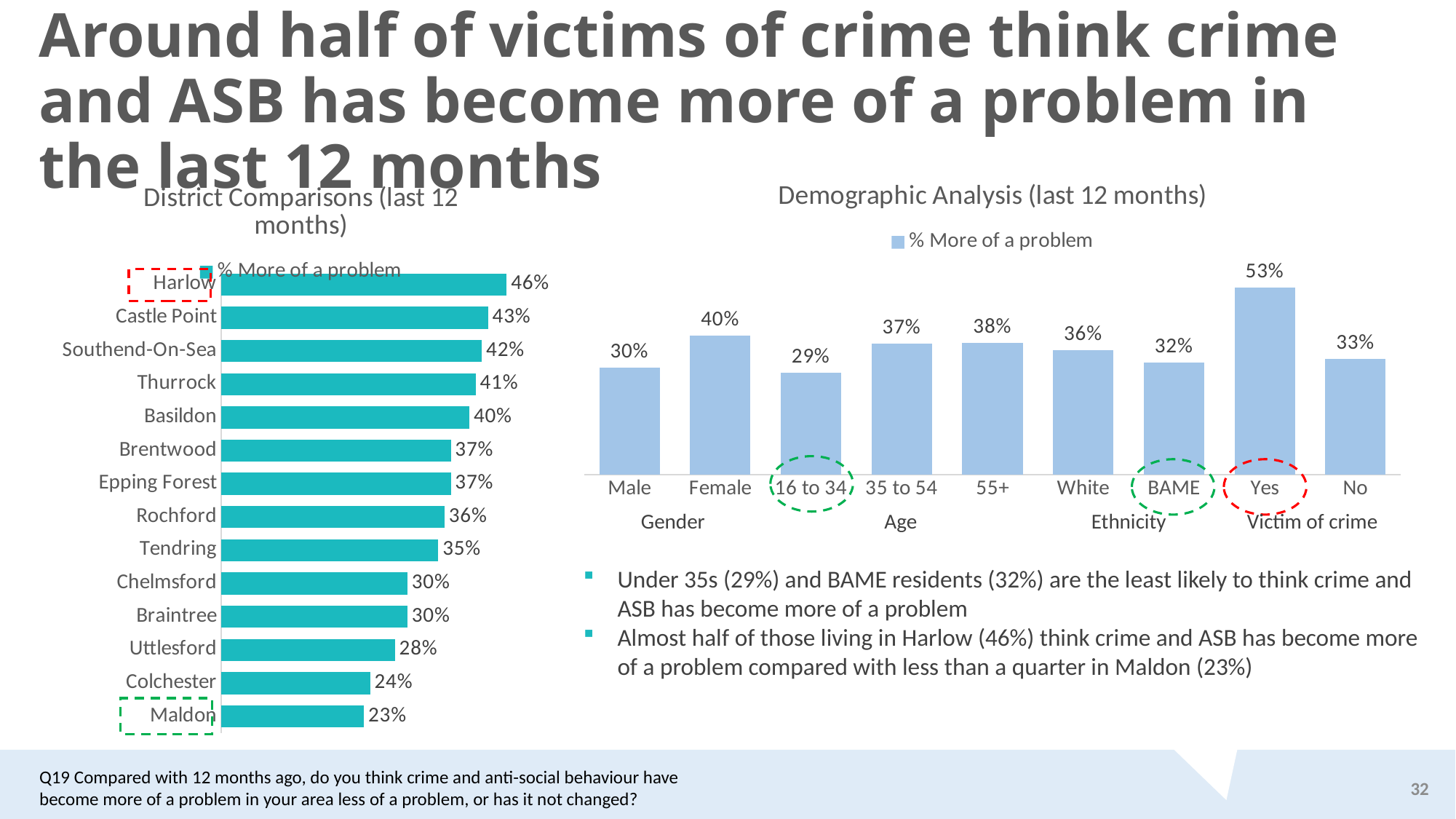
What type of chart is the Demographic Analysis chart? Bar chart In the Demographic Analysis chart, which category has the highest value? Yes In the Demographic Analysis chart, what is the value for Female? 40% In the District Comparisons chart, how many districts are shown? 14 In the Demographic Analysis chart, what is the difference between Yes and No under Victim of crime? 20% In the District Comparisons chart, which is larger, Tendring or Colchester? Tendring In the Demographic Analysis chart, what series does the legend list? % More of a problem In the District Comparisons chart, which district has the lowest value? Maldon In the District Comparisons chart, what is the difference between Harlow and Maldon? 23% In the District Comparisons chart, what is the value for Thurrock? 41% In the District Comparisons chart, what is the value for Harlow? 46% In the Demographic Analysis chart, which category has the lowest value? 16 to 34